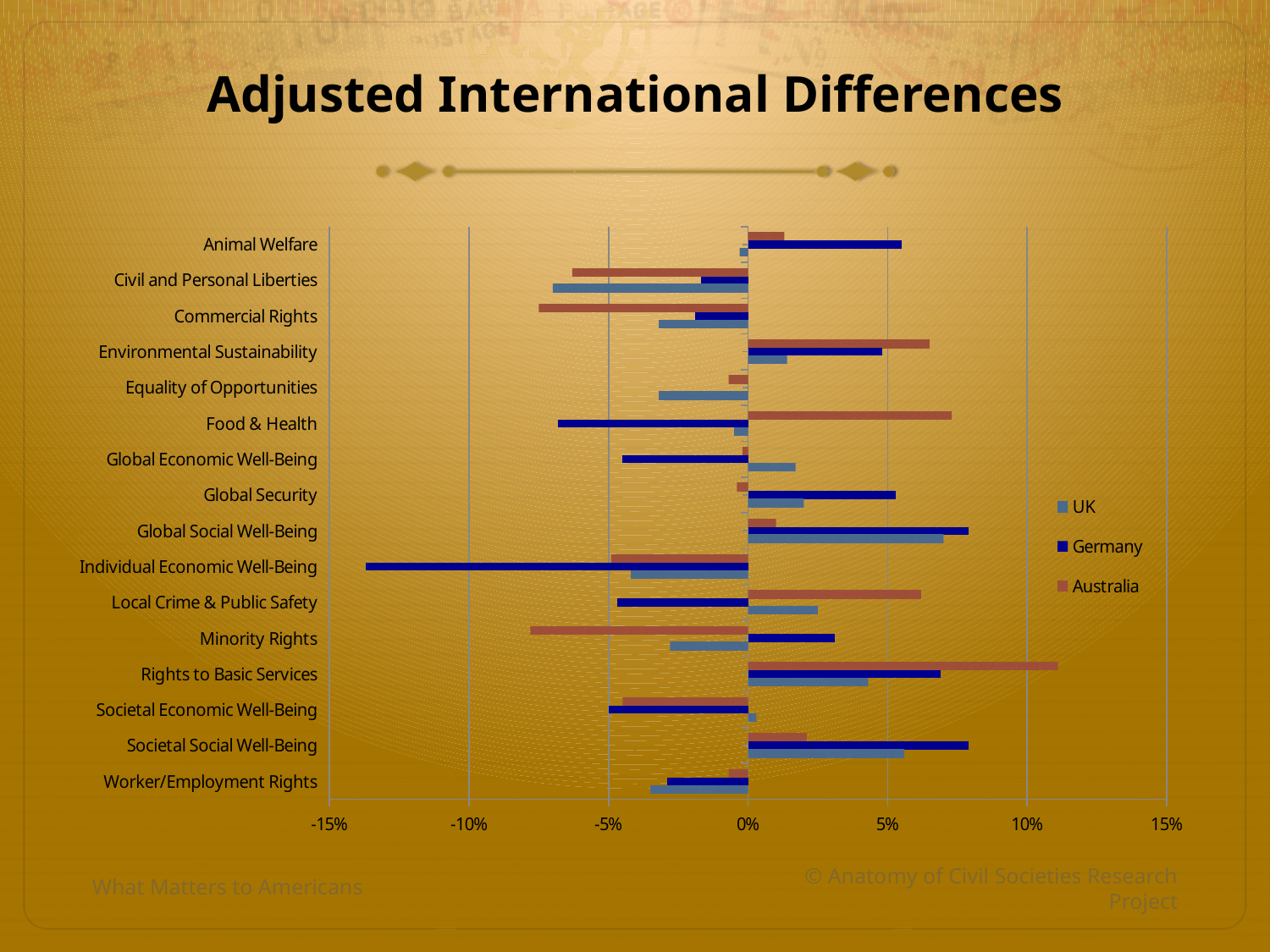
What kind of chart is shown on the slide? Bar chart Is the UK value for Civil and Personal Liberties greater or less than -5%? less Is the Germany value for Individual Economic Well-Being greater or less than -10%? less Which series is shown in dark blue in the legend? Germany For Food & Health, which is larger: the Germany value or the Australia value? Australia Is the Australia value for Rights to Basic Services greater or less than 10%? greater Which category has the lowest Germany value? Individual Economic Well-Being Which category has the highest Australia value? Rights to Basic Services How many categories are plotted on the vertical axis? 16 What is the title of the chart? Adjusted International Differences How many series does the legend list? 3